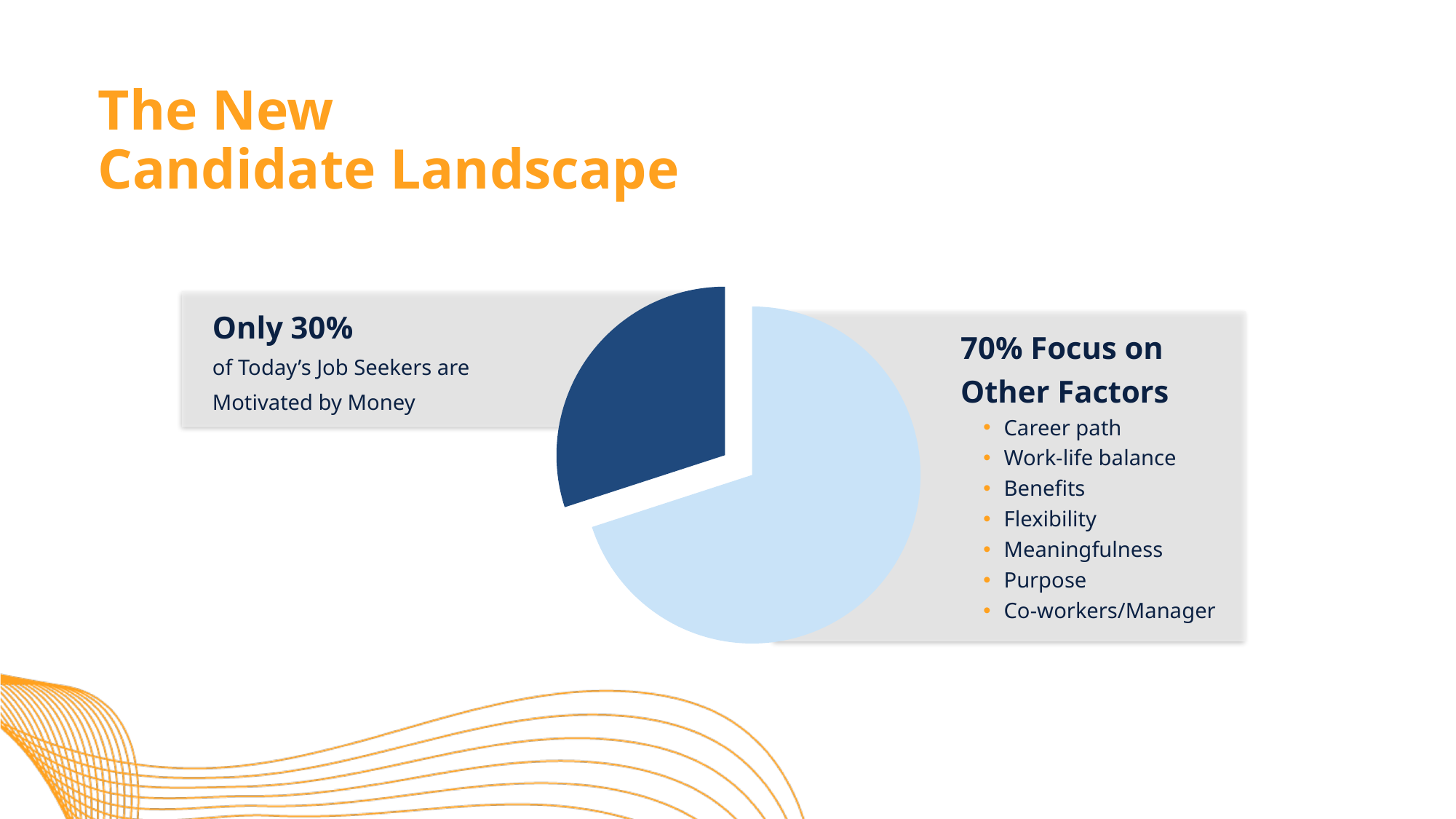
What kind of chart is shown on the slide? pie chart Which slice of the pie chart is the smallest? motivated by money (30%) What is the difference in percentage points between the 'other factors' slice and the 'motivated by money' slice? 40 percentage points What share of job seekers focus on other factors according to the pie chart? 70% How many 'other factors' are listed in the bullet list next to the pie chart? 7 What share of today's job seekers are motivated by money according to the pie chart? 30% Which slice of the pie chart is larger: motivated by money or focus on other factors? focus on other factors How many slices does the pie chart have? 2 Which slice of the pie chart is the largest? focus on other factors (70%) What colour is the slice representing job seekers motivated by money? dark blue